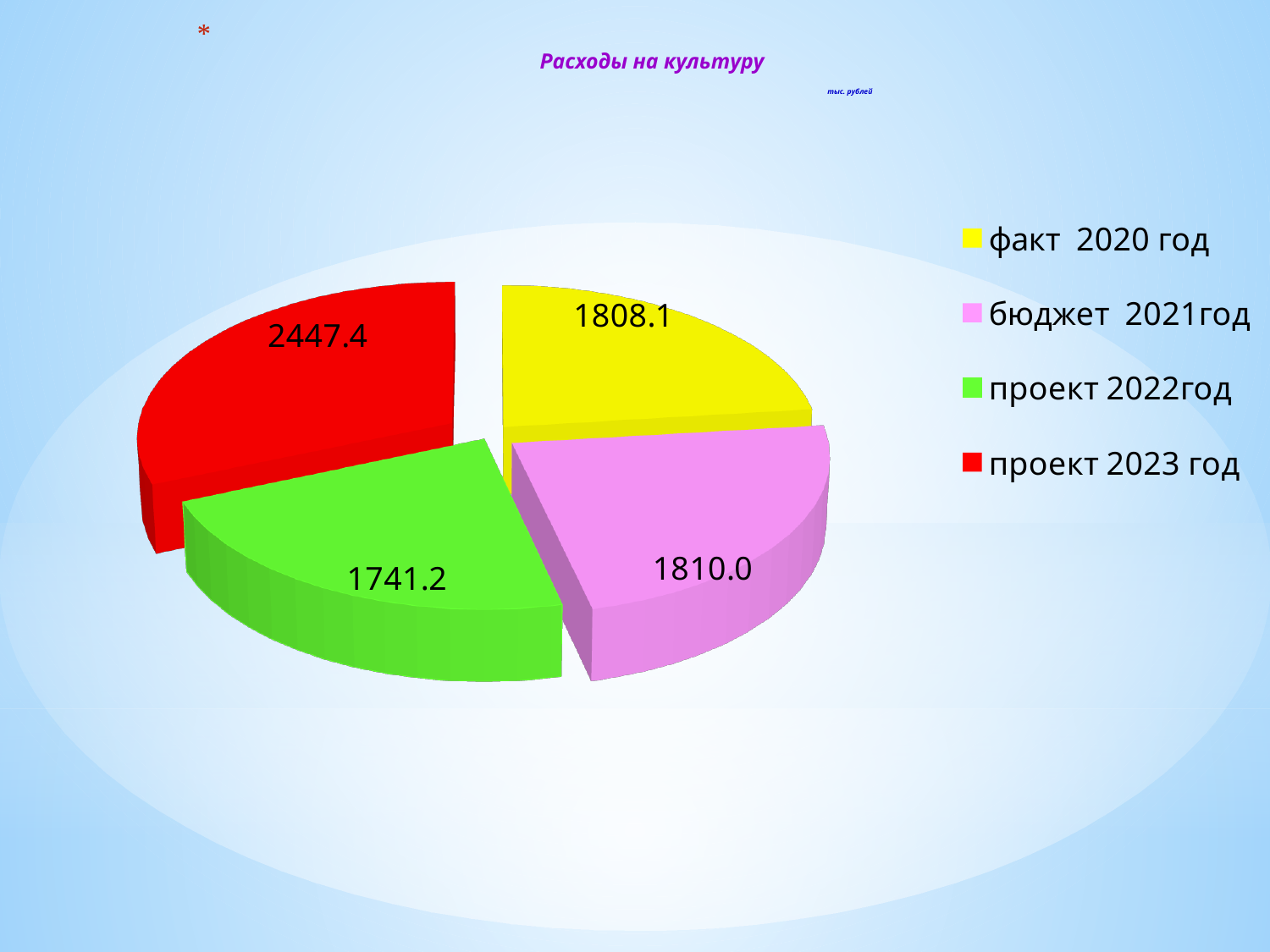
Which category has the largest slice of the pie? проект 2023 год What colour is the slice for проект 2022год? Green How many slices does the pie chart have? 4 What is the value for проект 2022год? 1741.2 What type of chart is shown on the slide? Pie chart Which is larger, the value for проект 2023 год or the value for проект 2022год? проект 2023 год What is the title of the chart? Расходы на культуру What is the difference between the values for проект 2023 год and факт 2020 год? 639.3 What is the value for проект 2023 год? 2447.4 Which category has the smallest slice of the pie? проект 2022год What is the value for бюджет 2021год? 1810.0 What is the value for факт 2020 год? 1808.1